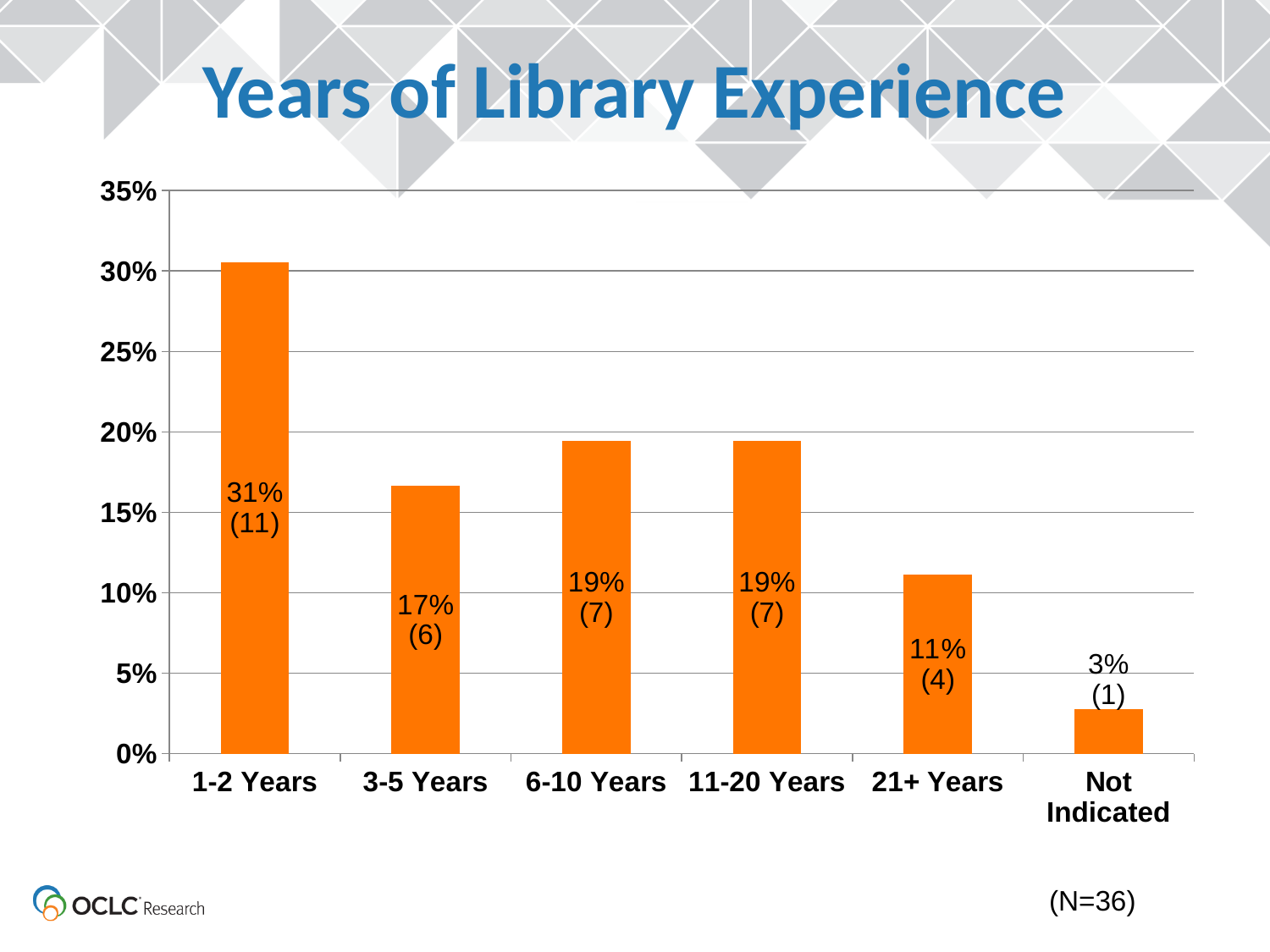
Which category has the highest percentage of respondents? 1-2 Years Which category has the lowest percentage of respondents? Not Indicated What percentage of respondents have 21+ years of library experience? 11% Which is larger, the percentage for 3-5 Years or for 6-10 Years? 6-10 Years How many categories are shown on the x axis? 6 What kind of chart is shown on the slide? Bar chart What percentage of respondents have 1-2 years of library experience? 31% Is the value for 11-20 Years greater or less than 20%? less How many respondents have 3-5 years of library experience? 6 What is the total number of respondents (N) noted on the slide? 36 What is the title of the chart? Years of Library Experience What is the difference in percentage points between the 1-2 Years and 21+ Years categories? 20